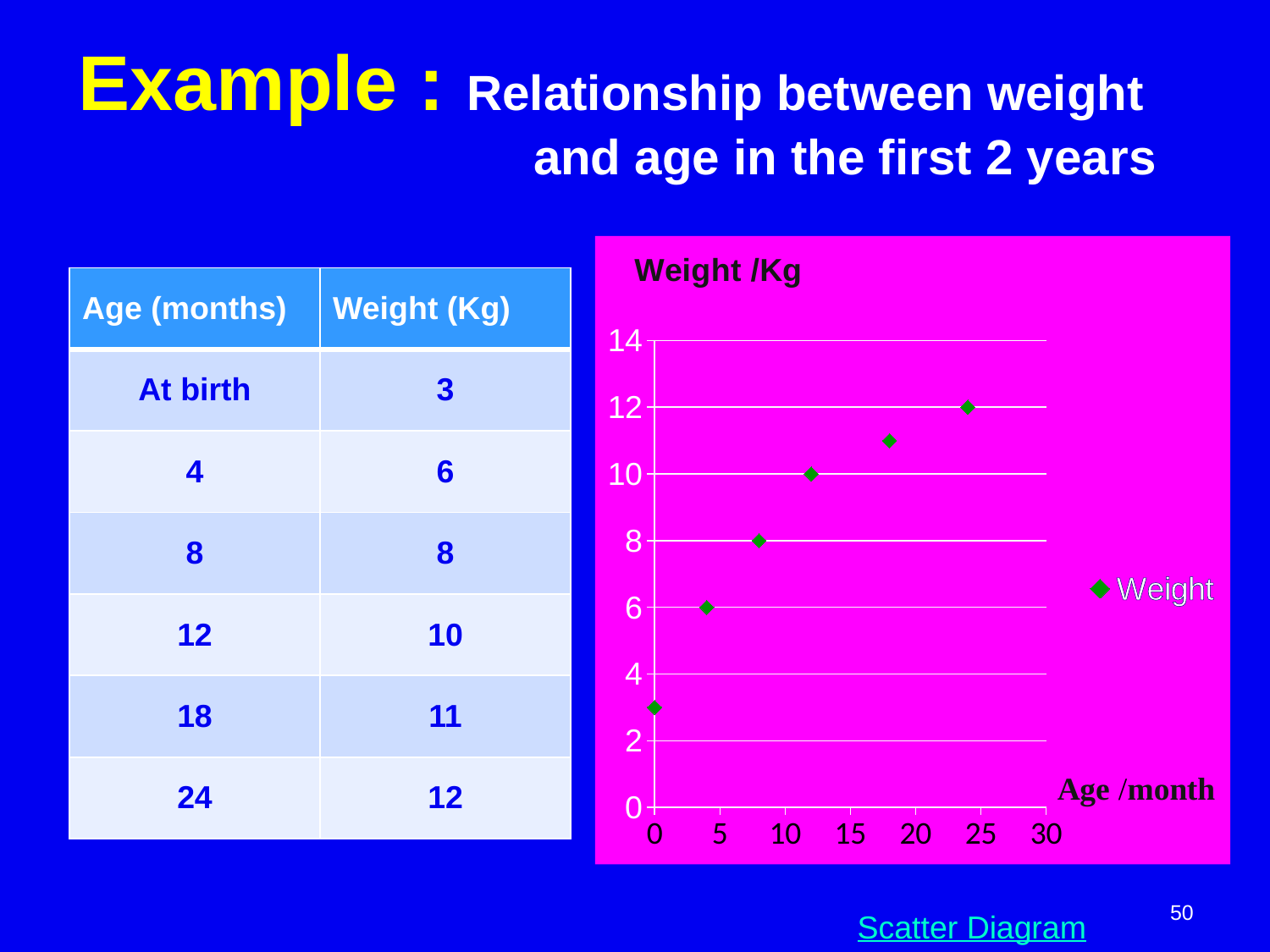
What is the label of the series shown in the chart legend? Weight At which age is the weight lowest? At birth Do the weight values rise or fall as age increases along the x axis? Rise How many series does the chart legend list? 1 What is the weight in Kg at age 24 months? 12 What kind of chart is shown on the slide? Scatter chart What is the difference in weight between age 24 months and age 8 months? 4 What is the weight in Kg at age 12 months? 10 What is the weight in Kg at age 4 months? 6 Is the weight at age 18 months greater or less than 10? greater At which age is the weight highest? 24 months How many data points are plotted on the chart? 6